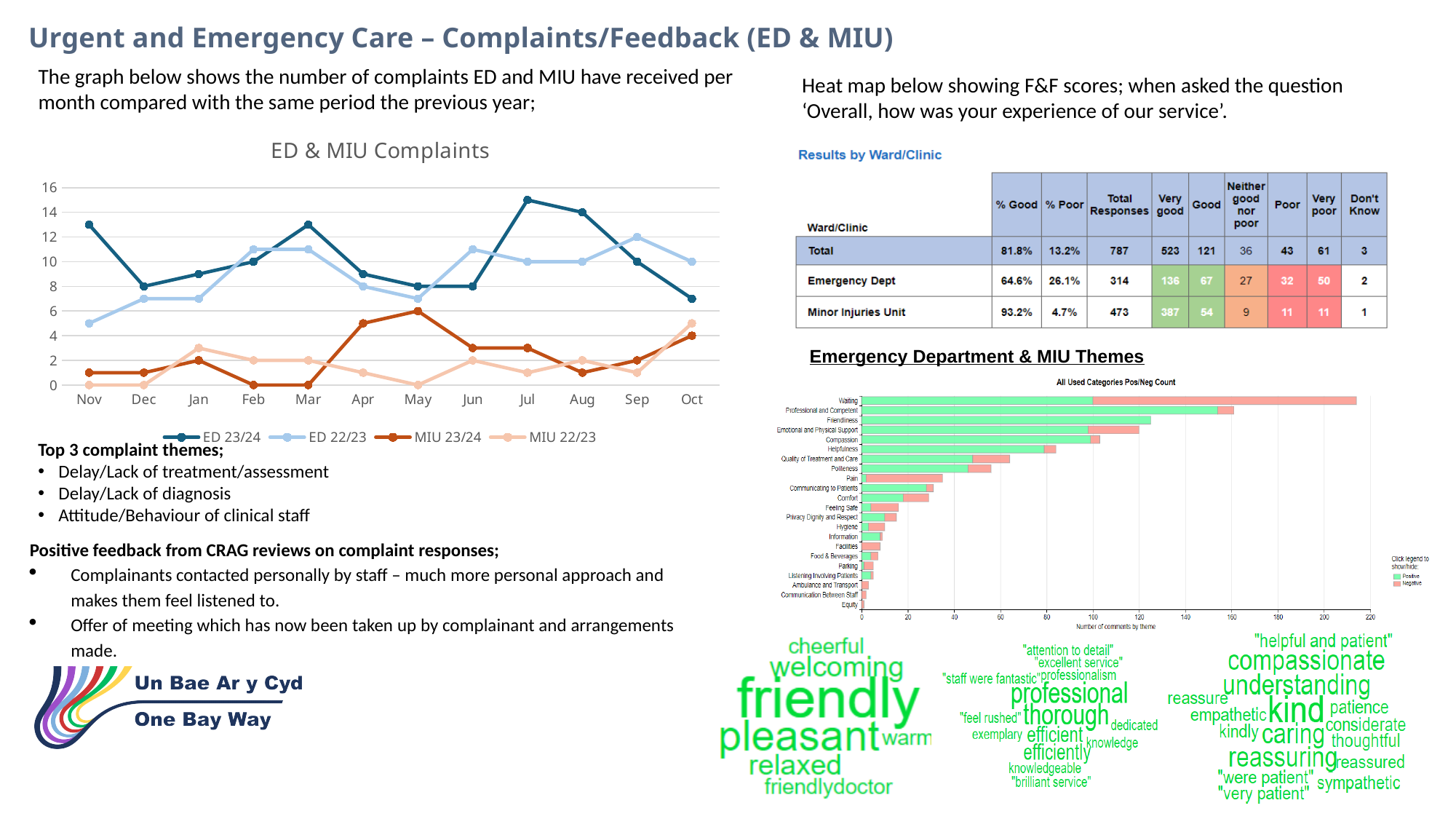
In the ED & MIU Complaints chart, does the ED 23/24 line rise or fall from Aug to Oct? fall In the ED & MIU Complaints chart, how many months are shown on the x axis? 12 In the All Used Categories Pos/Neg Count chart, what two entries does the legend list? Positive, Negative In the ED & MIU Complaints chart, what is the ED 23/24 value for Aug? 14 In the ED & MIU Complaints chart, in which month is ED 22/23 lowest? Nov In the All Used Categories Pos/Neg Count chart, which theme has the longest bar? Waiting In the ED & MIU Complaints chart, what type of chart is used? line chart In the ED & MIU Complaints chart, how many series does the legend list? 4 In the ED & MIU Complaints chart, what is the MIU 23/24 value for May? 6 In the ED & MIU Complaints chart, in which month is ED 23/24 highest? Jul In the ED & MIU Complaints chart, is the ED 23/24 value for Nov greater or less than 12? greater In the ED & MIU Complaints chart, what is the ED 22/23 value for Sep? 12